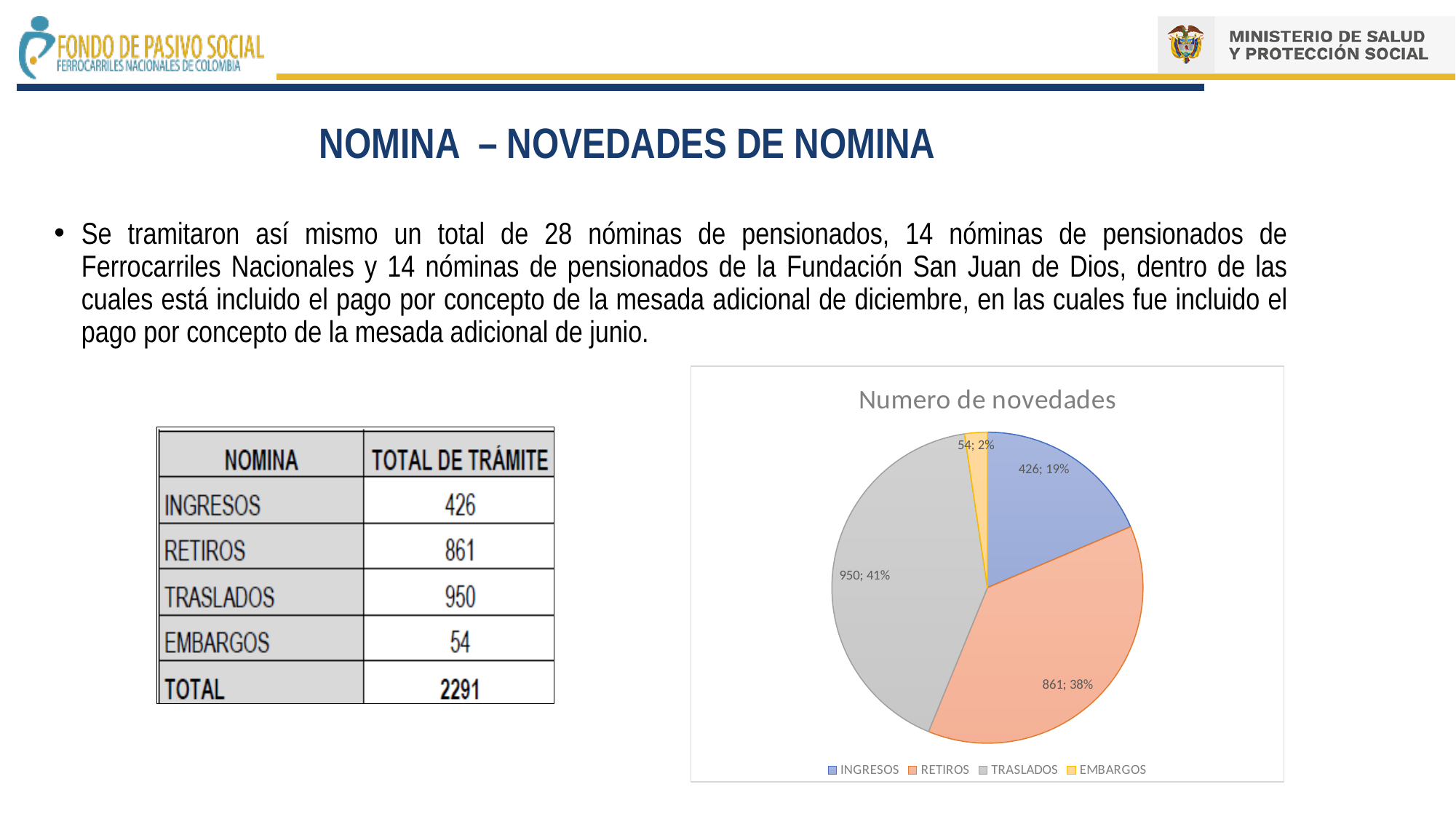
Which category has the largest slice in the chart? TRASLADOS What share of the pie does RETIROS represent? 38% Which is larger, the value for INGRESOS or the value for RETIROS? RETIROS What is the value for TRASLADOS in the chart? 950 What type of chart is shown on the slide? pie chart Which category has the smallest slice in the chart? EMBARGOS What is the value for INGRESOS in the chart? 426 What is the difference between the values for TRASLADOS and RETIROS? 89 What is the value for EMBARGOS in the chart? 54 What is the title of the chart? Numero de novedades What share of the pie does INGRESOS represent? 19% How many categories does the legend of the chart list? 4